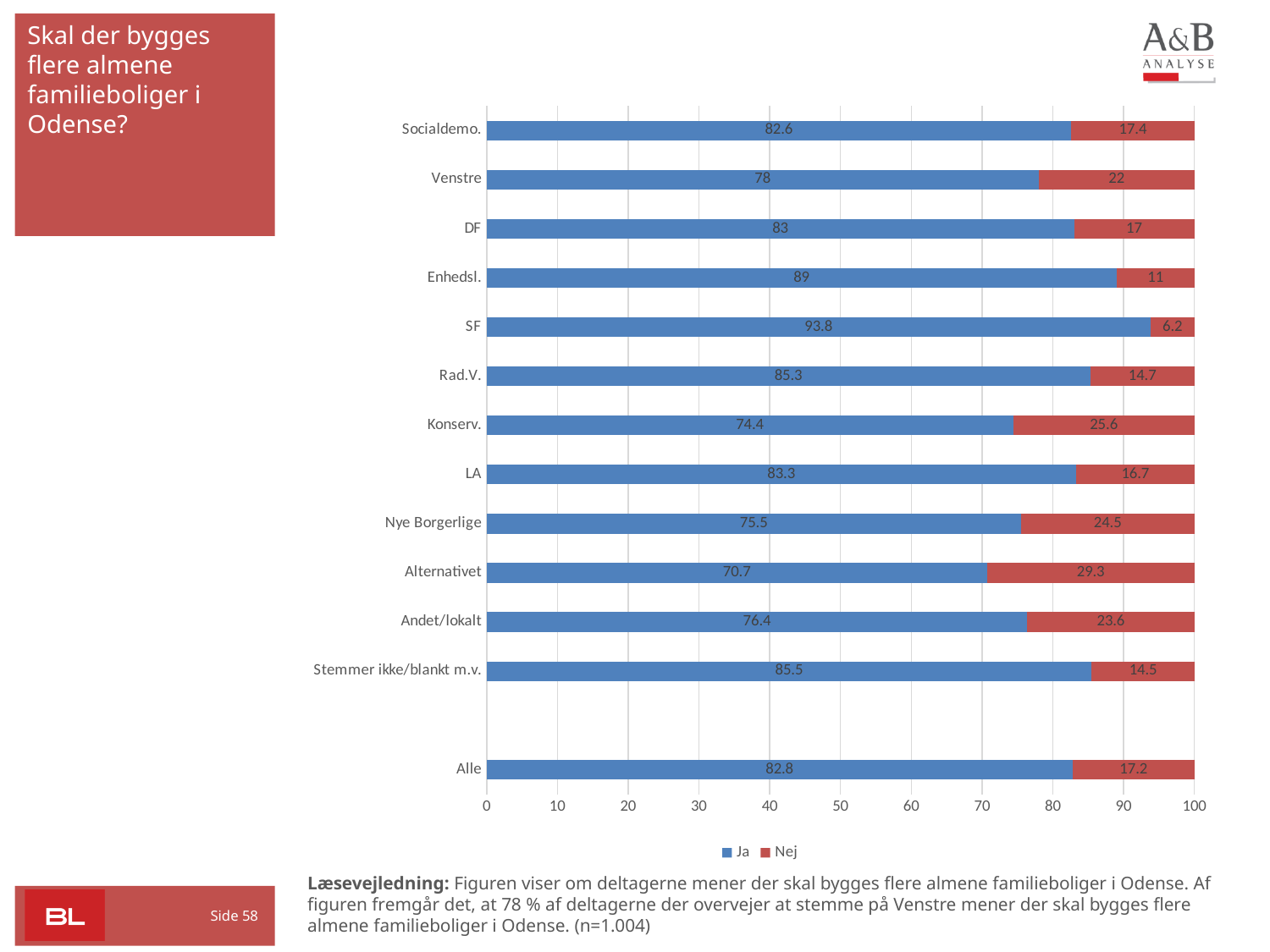
What is the Nej value for Konserv.? 25.6 What is the Ja value for Stemmer ikke/blankt m.v.? 85.5 What is the difference between the Ja value for SF and the Ja value for Alternativet? 23.1 What is the Ja value for Venstre? 78 What kind of chart is shown on the slide? Stacked bar chart Which has a larger Ja value, Enhedsl. or DF? Enhedsl. How many series does the legend list? 2 Which category has the lowest Ja value? Alternativet Which category has the highest Nej value? Alternativet How many categories are shown on the chart? 13 What is the total of the stacked bar for Socialdemo.? 100 Which category has the highest Ja value? SF